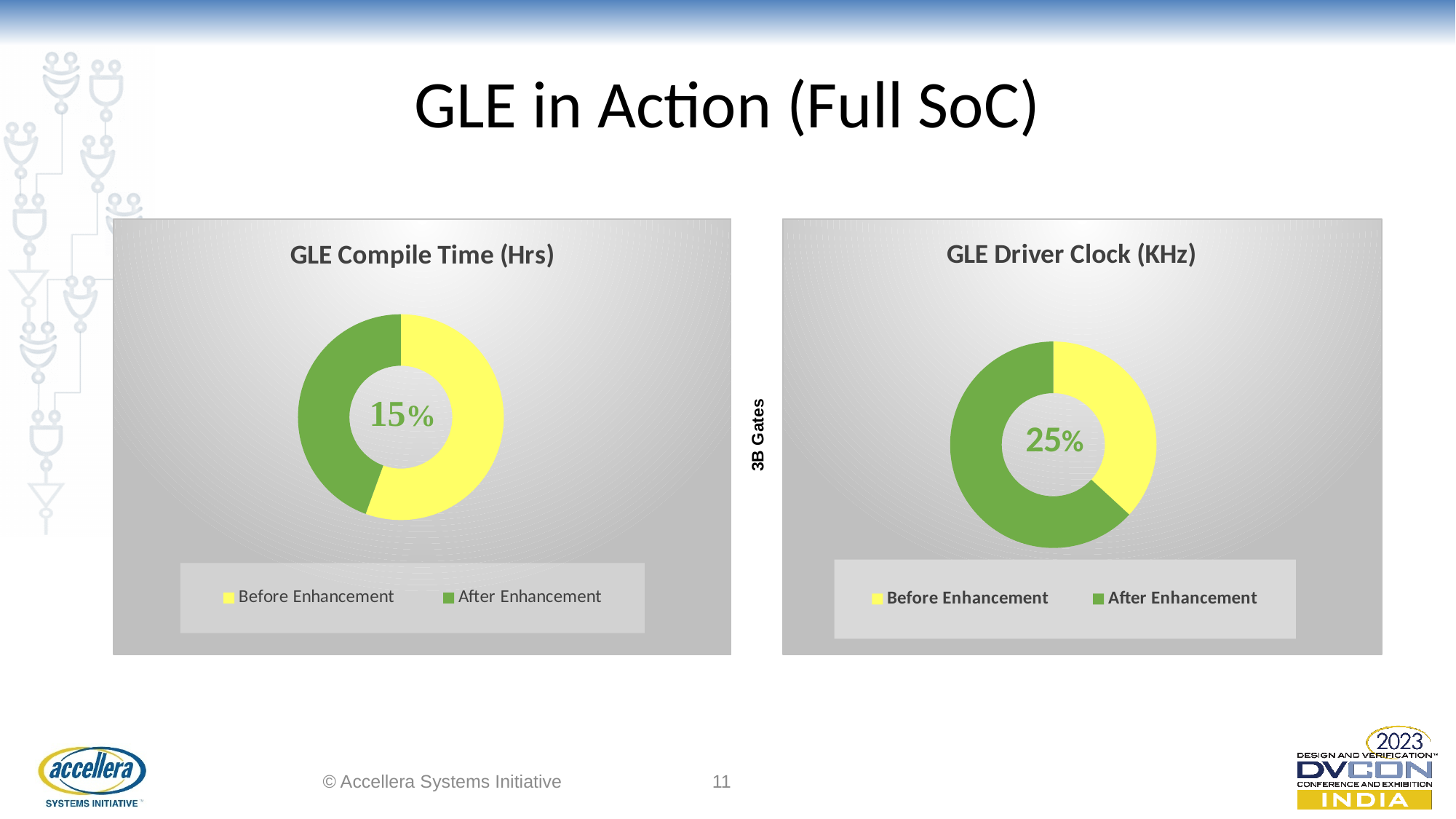
In the GLE Driver Clock (KHz) chart, which series has the smallest slice? Before Enhancement What colour represents After Enhancement in the GLE Compile Time (Hrs) chart? Green What kind of chart is the GLE Driver Clock (KHz) chart? Doughnut chart What are the two legend entries of the GLE Driver Clock (KHz) chart? Before Enhancement and After Enhancement How many slices does the GLE Compile Time (Hrs) doughnut have? 2 How many series does the legend of the GLE Driver Clock (KHz) chart list? 2 In the GLE Compile Time (Hrs) chart, which slice is larger: Before Enhancement or After Enhancement? Before Enhancement In the GLE Driver Clock (KHz) chart, which slice is larger: Before Enhancement or After Enhancement? After Enhancement What kind of chart is the GLE Compile Time (Hrs) chart? Doughnut chart How many series does the legend of the GLE Compile Time (Hrs) chart list? 2 What percentage is printed in the centre of the GLE Compile Time (Hrs) chart? 15% What percentage is printed in the centre of the GLE Driver Clock (KHz) chart? 25%